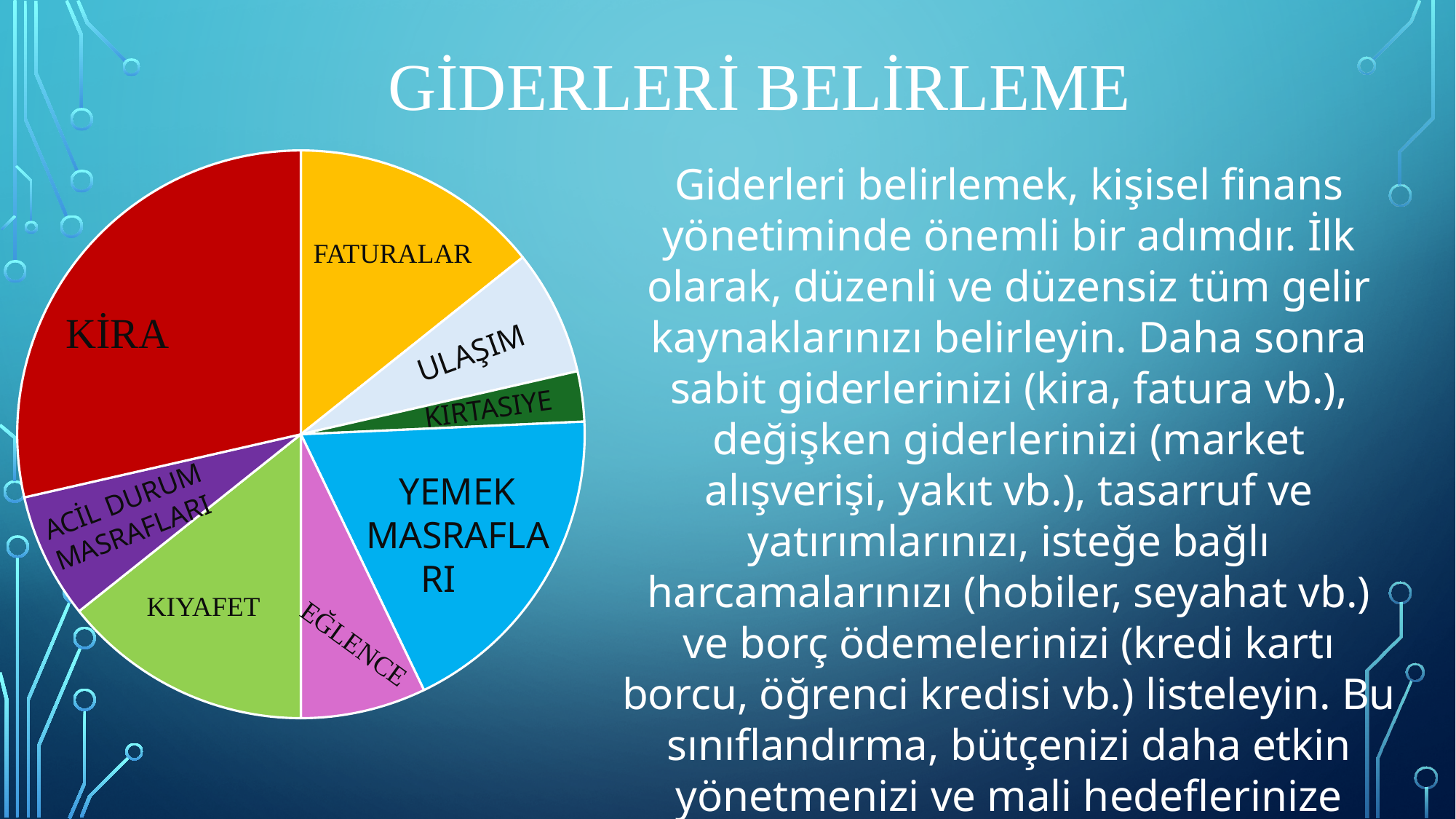
How many slices does the pie chart have? 8 Which category has the smallest slice in the pie chart? KIRTASIYE Which slice is larger, KIRTASIYE or ACİL DURUM MASRAFLARI? ACİL DURUM MASRAFLARI Which slice is larger, FATURALAR or KIRTASIYE? FATURALAR Which slice is larger, YEMEK MASRAFLARI or ULAŞIM? YEMEK MASRAFLARI What colour is the YEMEK MASRAFLARI slice in the pie chart? blue Which category has the largest slice in the pie chart? KİRA What colour is the KİRA slice in the pie chart? red What kind of chart is shown on the slide? pie chart